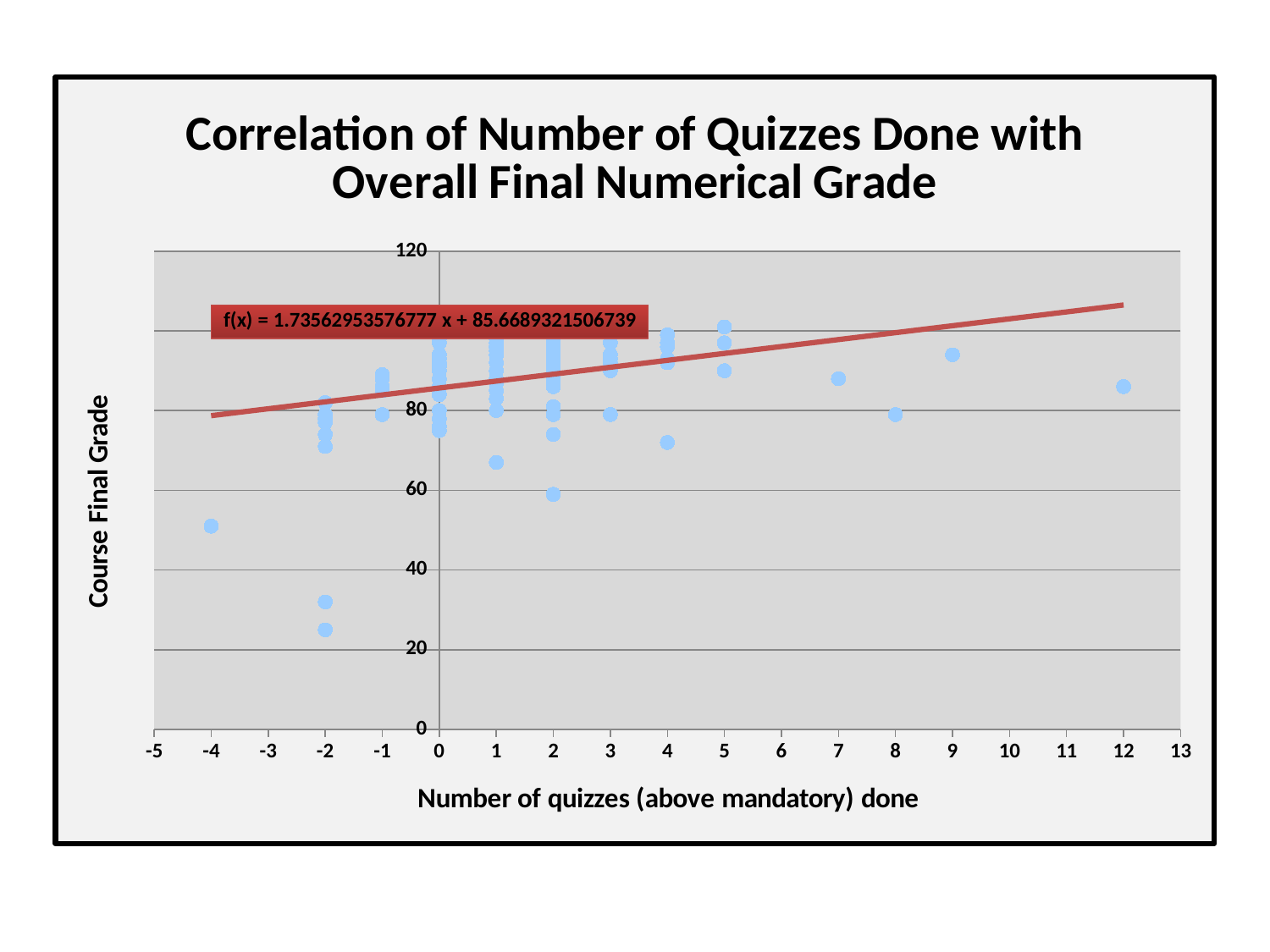
What is the title of the chart? Correlation of Number of Quizzes Done with Overall Final Numerical Grade What is the slope of the trendline equation shown on the chart? 1.73562953576777 What kind of chart is shown on the slide? scatter chart Is the lowest point at -2 quizzes greater or less than 40? less Is the value for the point at 12 quizzes greater or less than 80? greater Which has the higher final grade: the point at 12 quizzes or the point at -4 quizzes? 12 quizzes Is the value for the point at 9 quizzes greater or less than 80? greater Does the trendline rise or fall as the number of quizzes done increases? rises What is the label of the vertical axis? Course Final Grade How many data points are plotted at 12 quizzes? 1